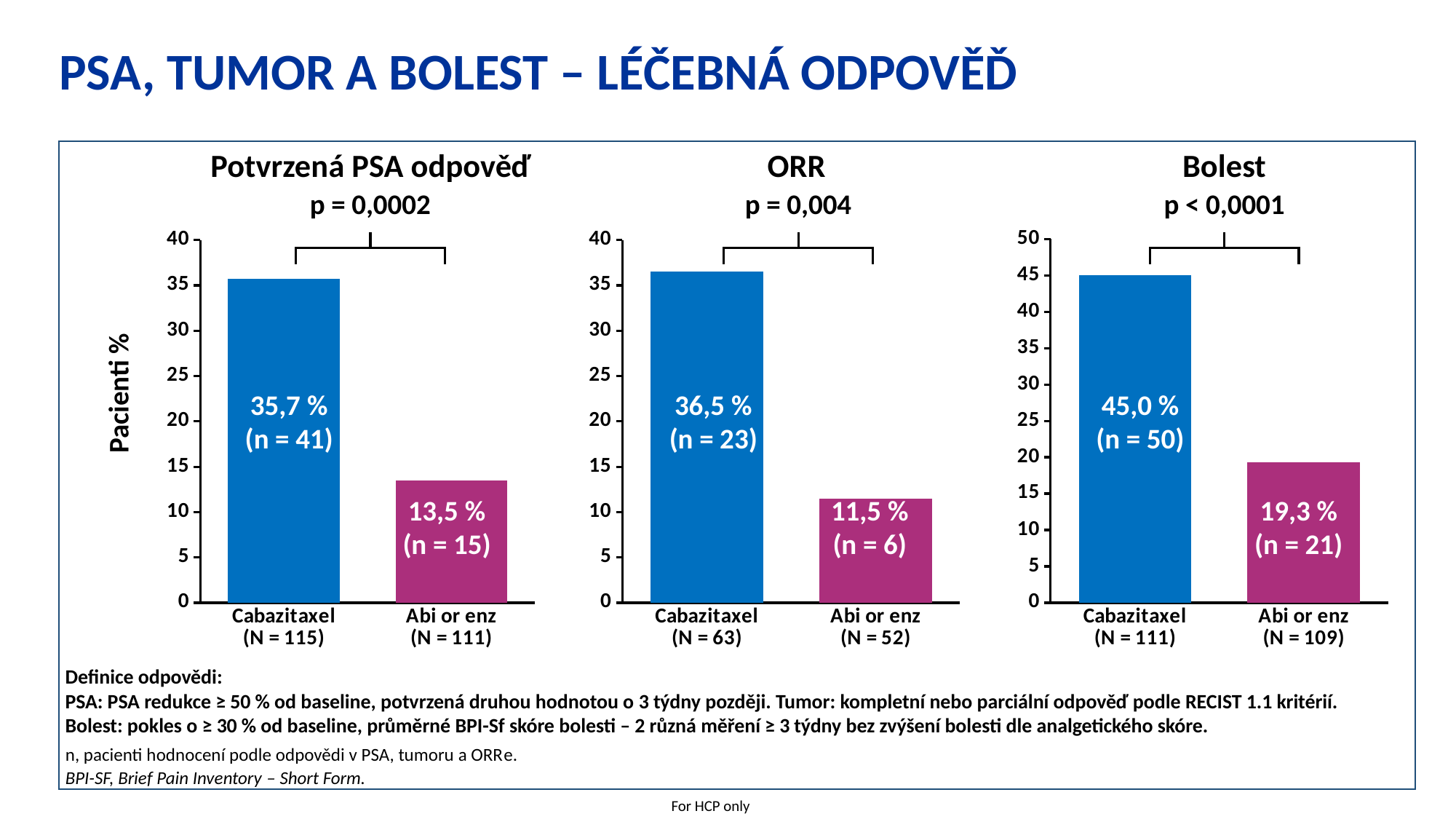
In the 'Potvrzená PSA odpověď' chart, what is the value for Cabazitaxel? 35,7 % How many bars are plotted in the 'Bolest' chart? 2 In the 'Potvrzená PSA odpověď' chart, what is the value for Abi or enz? 13,5 % In the 'Bolest' chart, what is the value for Cabazitaxel? 45,0 % In the 'ORR' chart, which category has the highest value? Cabazitaxel In the 'ORR' chart, what is the value for Abi or enz? 11,5 % In the 'ORR' chart, is the value for Cabazitaxel greater or less than 35? greater In the 'Bolest' chart, which category has the lowest value? Abi or enz In the 'Bolest' chart, what is the difference between the Cabazitaxel and Abi or enz values? 25,7 % In the 'Potvrzená PSA odpověď' chart, what is the difference between the Cabazitaxel and Abi or enz values? 22,2 % In the 'Bolest' chart, how many patients (n) responded in the Abi or enz group? n = 21 What type of chart is the 'ORR' chart? Bar chart